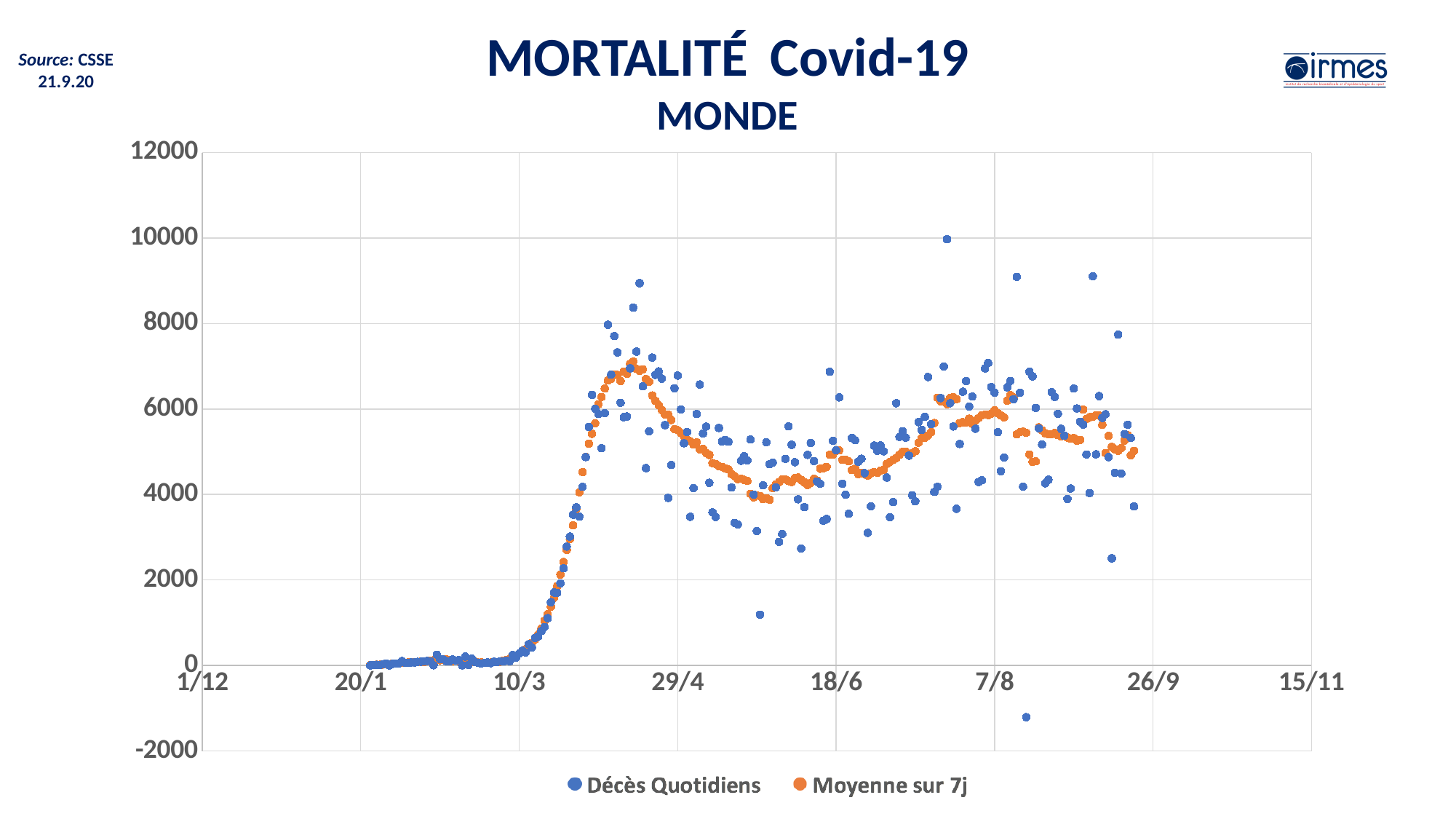
Is the peak of the Moyenne sur 7j series in April greater or less than 6000? greater How many series does the legend list? 2 What is the title of the chart? MORTALITÉ Covid-19 MONDE Is the highest Décès Quotidiens value on the chart greater or less than 8000? greater What kind of chart is shown on the slide? scatter chart Is the Moyenne sur 7j value around 7/8 greater or less than 4000? greater Is the Moyenne sur 7j value higher around 29/4 or around 18/6? 29/4 Between 29/4 and 18/6, do the Moyenne sur 7j values rise or fall? fall What are the two series named in the legend? Décès Quotidiens and Moyenne sur 7j Between 10/3 and 29/4, do the Moyenne sur 7j values rise or fall? rise